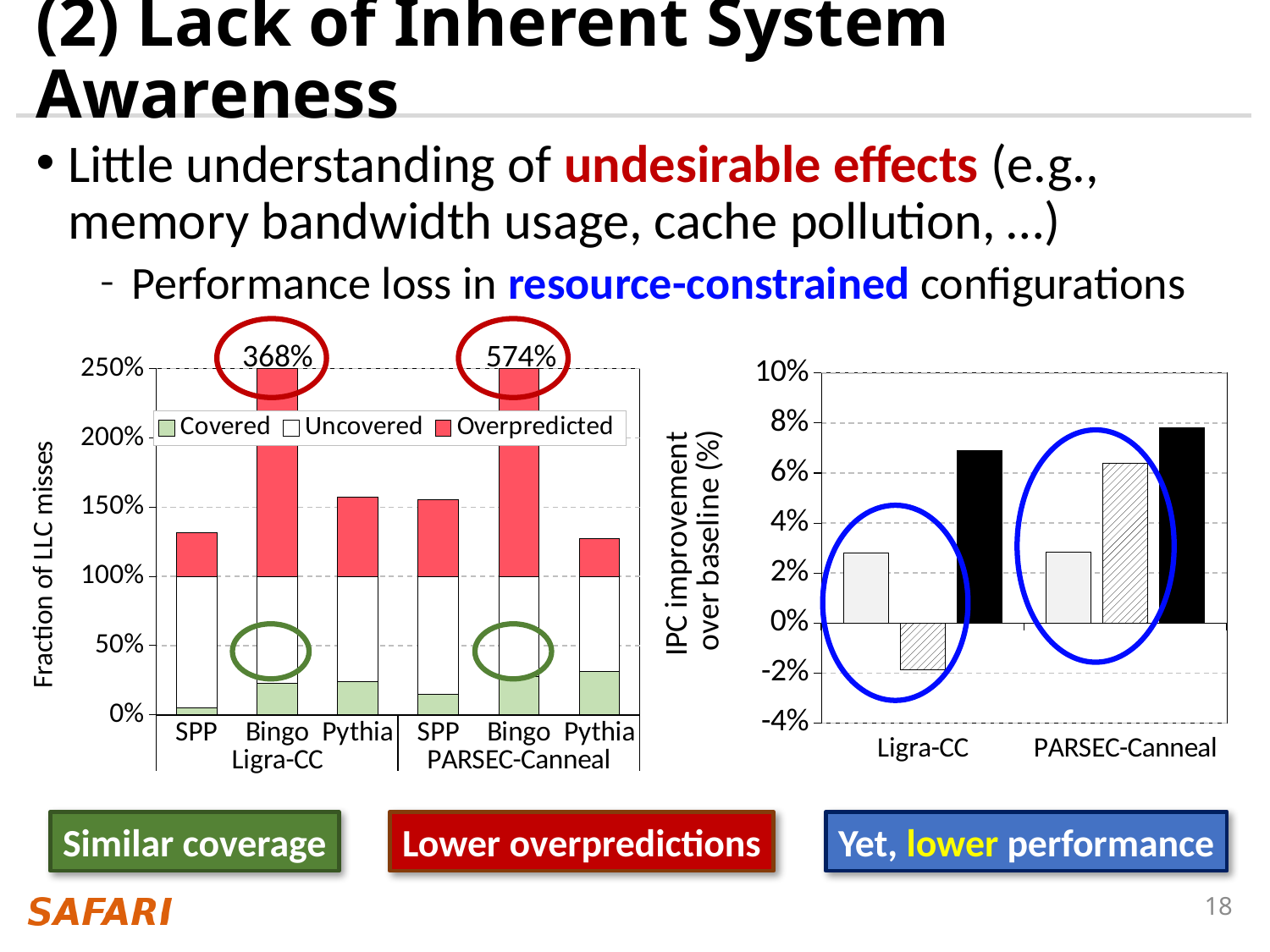
In the left chart (Fraction of LLC misses), which bar is the highest? Bingo (PARSEC-Canneal) What kind of chart is the left chart (Fraction of LLC misses)? Stacked bar chart In the left chart (Fraction of LLC misses), what is the difference between the Bingo value for PARSEC-Canneal and the Bingo value for Ligra-CC? 206% In the right chart (IPC improvement over baseline), how many categories are shown on the x axis? 2 In the left chart (Fraction of LLC misses), how many series does the legend list? 3 In the left chart (Fraction of LLC misses), what are the three legend entries? Covered, Uncovered, Overpredicted In the left chart (Fraction of LLC misses), what value is labeled above the Bingo bar for PARSEC-Canneal? 574% In the left chart (Fraction of LLC misses), what value is labeled above the Bingo bar for Ligra-CC? 368% In the left chart (Fraction of LLC misses), is the total for Pythia in PARSEC-Canneal greater or less than 150%? less In the left chart (Fraction of LLC misses), which is larger: the Bingo bar for Ligra-CC or the Bingo bar for PARSEC-Canneal? Bingo for PARSEC-Canneal In the left chart (Fraction of LLC misses), how many stacked bars are plotted? 6 In the right chart (IPC improvement over baseline), is the black bar for PARSEC-Canneal greater or less than 6%? greater